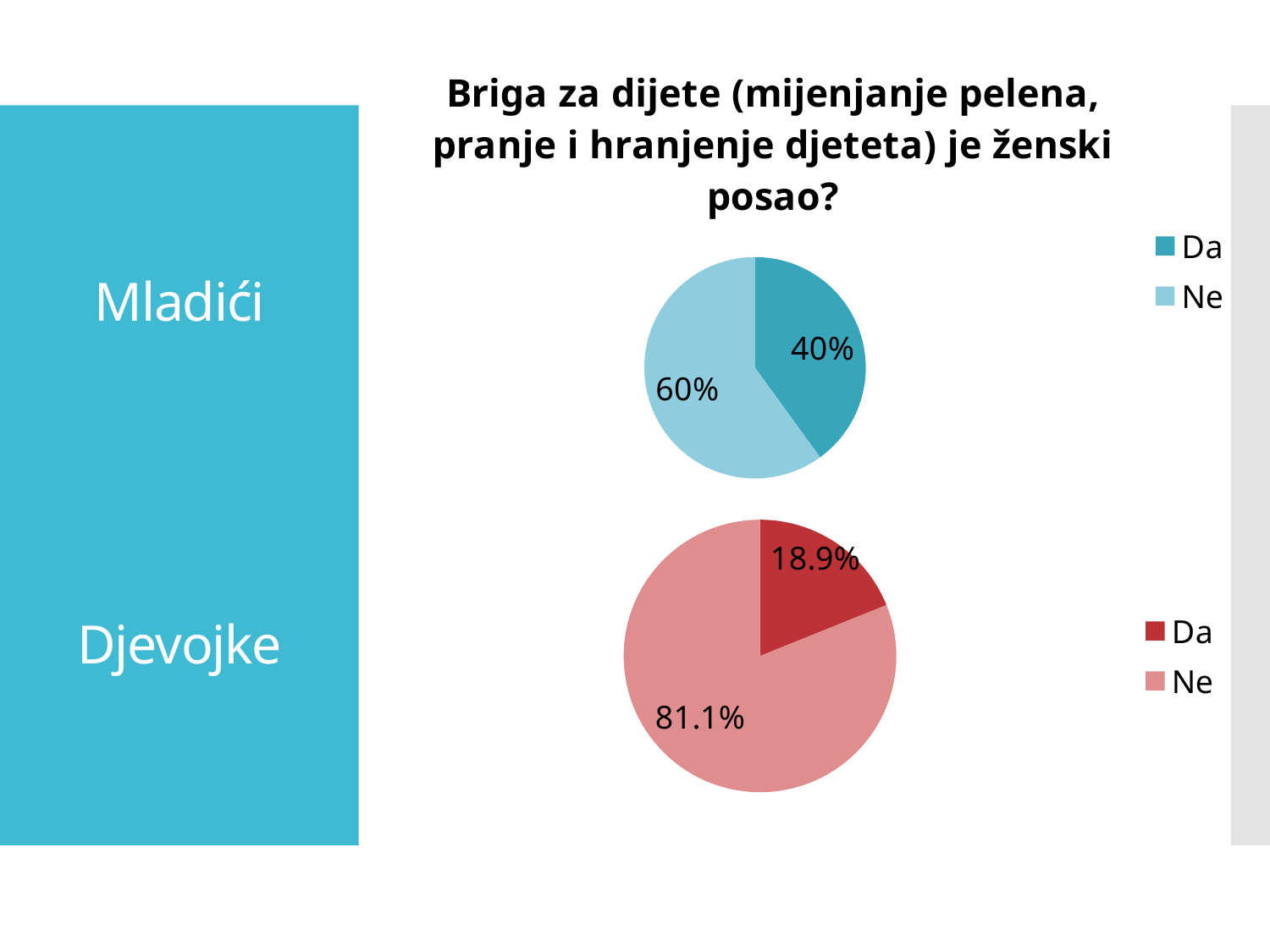
In the top pie chart (Mladići), which answer has the larger share? Ne What type of chart is used on this slide? Pie chart What is the title shown above the charts? Briga za dijete (mijenjanje pelena, pranje i hranjenje djeteta) je ženski posao? In the bottom pie chart (Djevojke), which answer has the smaller share? Da In the top pie chart (Mladići), what percentage answered "Da"? 40% In the top pie chart (Mladići), what is the difference between the "Ne" and "Da" shares? 20% Which is larger: the "Da" share in the top pie chart (Mladići) or the "Da" share in the bottom pie chart (Djevojke)? Mladići In the bottom pie chart (Djevojke), what is the difference between the "Ne" and "Da" shares? 62.2% In the bottom pie chart (Djevojke), what percentage answered "Da"? 18.9% How many slices does the bottom pie chart (Djevojke) have? 2 In the bottom pie chart (Djevojke), what percentage answered "Ne"? 81.1% In the top pie chart (Mladići), what percentage answered "Ne"? 60%